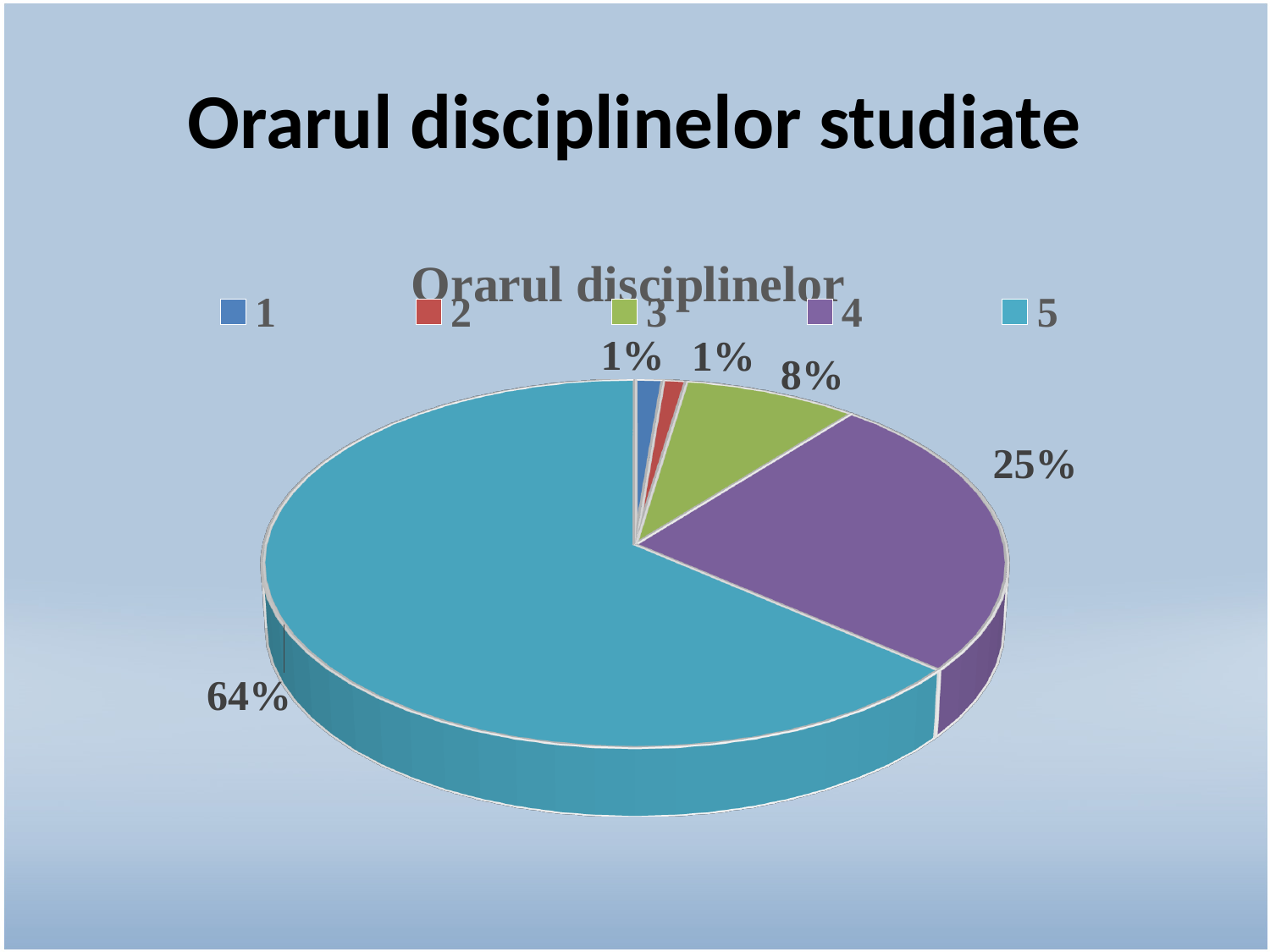
Which is larger, the slice for category 3 or the slice for category 4? 4 What is the difference between the shares of category 5 and category 4? 39% Which category has the largest slice of the pie? 5 What share of the pie does category 3 have? 8% What share of the pie does category 5 have? 64% How many entries does the legend list? 5 What share of the pie does category 4 have? 25% What colour is the slice for category 4? purple What is the chart's title? Orarul disciplinelor What kind of chart is shown on the slide? pie chart How many slices does the pie chart have? 5